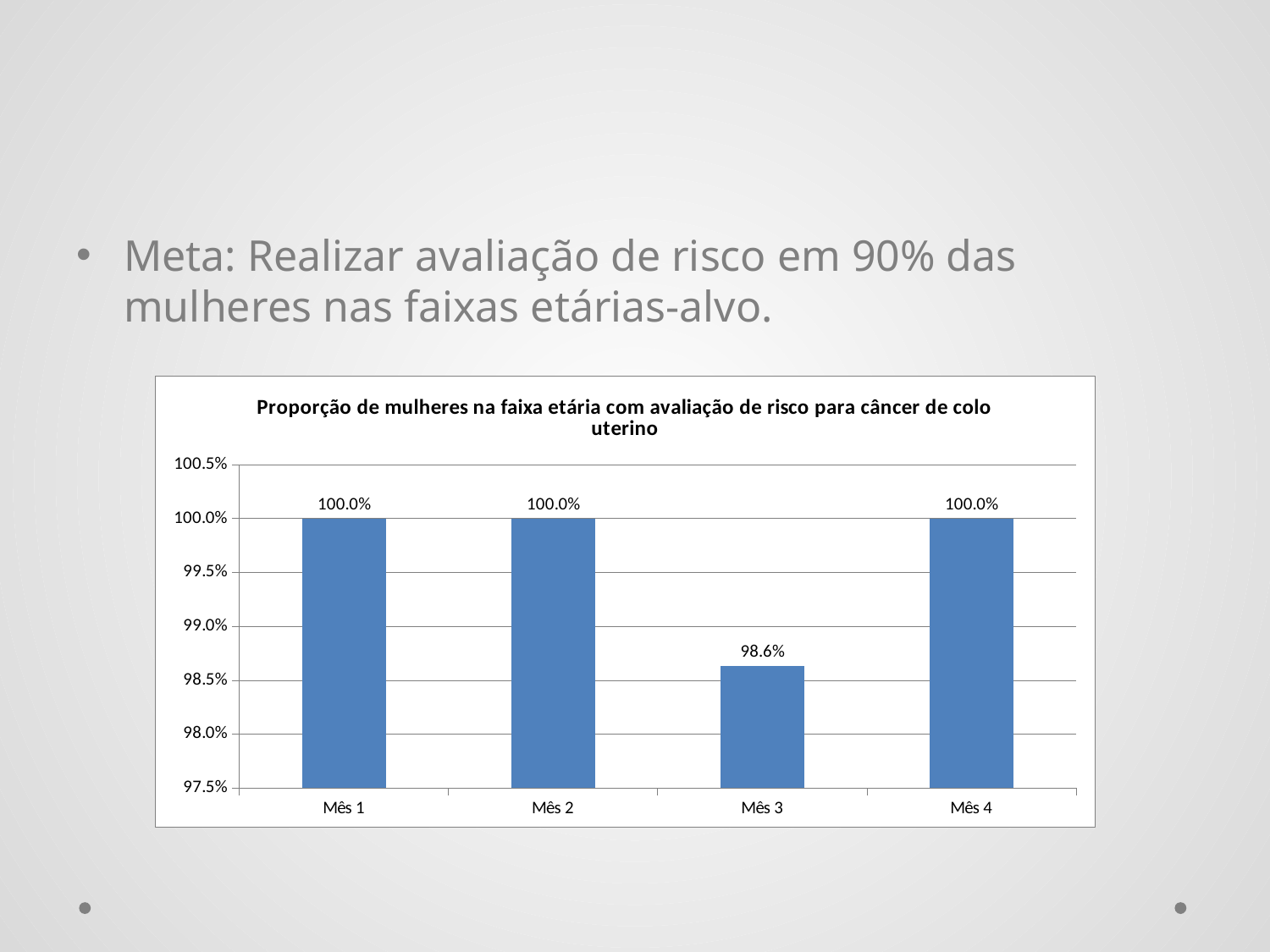
Which month has the lowest value? Mês 3 How many months are shown on the x axis? 4 What is the value for Mês 3? 98.6% What is the value for Mês 4? 100.0% How many months have a value of 100.0%? 3 What is the title of the chart? Proporção de mulheres na faixa etária com avaliação de risco para câncer de colo uterino What is the value for Mês 1? 100.0% What kind of chart is shown on the slide? bar chart What colour are the bars in the chart? blue What is the difference between the values for Mês 2 and Mês 3? 1.4% Is the value for Mês 3 greater or less than 99.0%? less Which is larger, the value for Mês 3 or the value for Mês 4? Mês 4